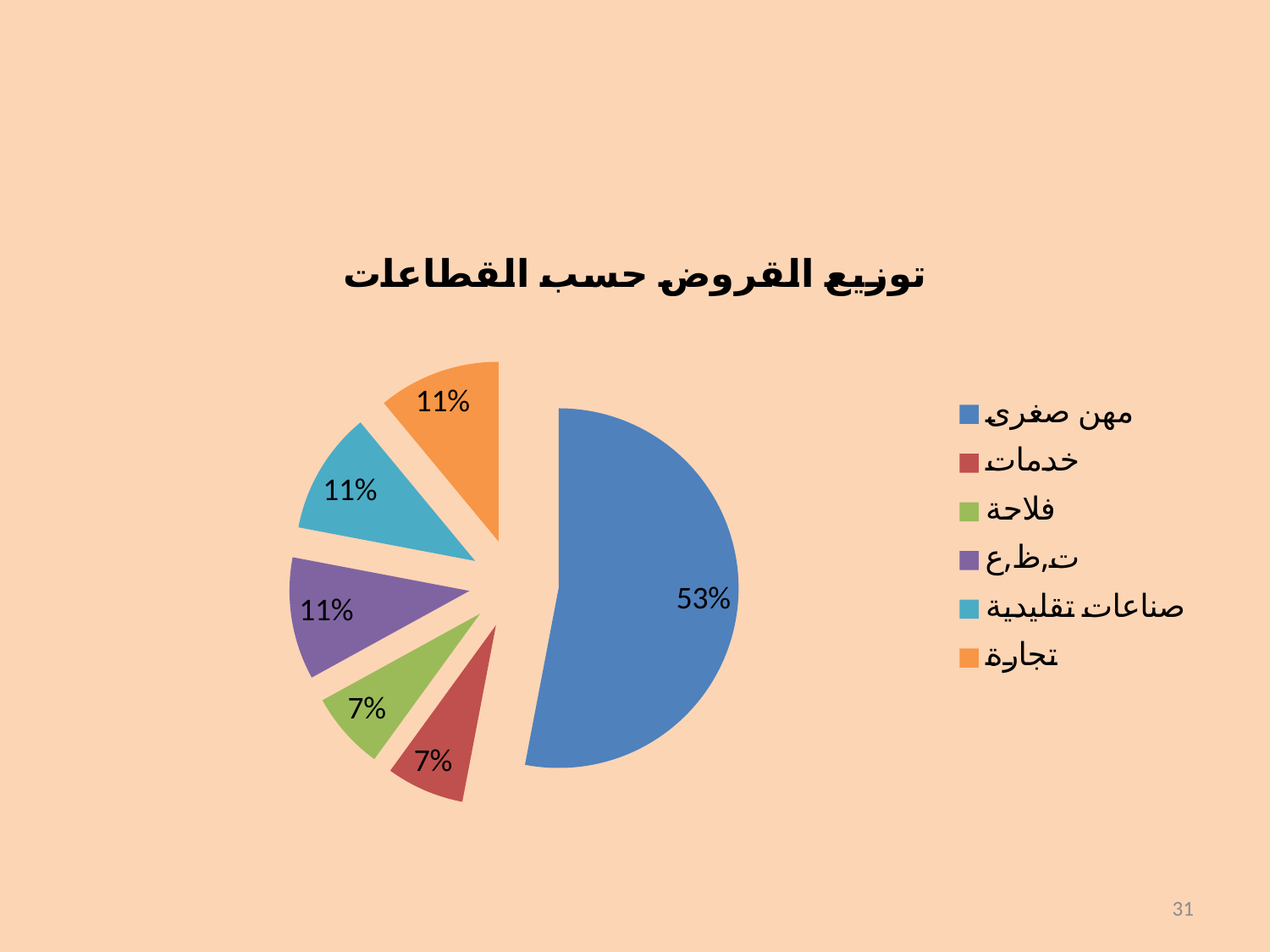
How many entries does the legend list? 6 What share of the pie does مهن صغرى have? 53% What kind of chart is shown on the slide? pie chart Which is larger, the share for تجارة or the share for خدمات? تجارة How many slices does the pie chart have? 6 What share of the pie does فلاحة have? 7% What is the difference between the share for مهن صغرى and the share for ت.ظ.ع? 42% What share of the pie does خدمات have? 7% Which sector has the largest share of the pie? مهن صغرى What is the title of the chart? توزيع القروض حسب القطاعات